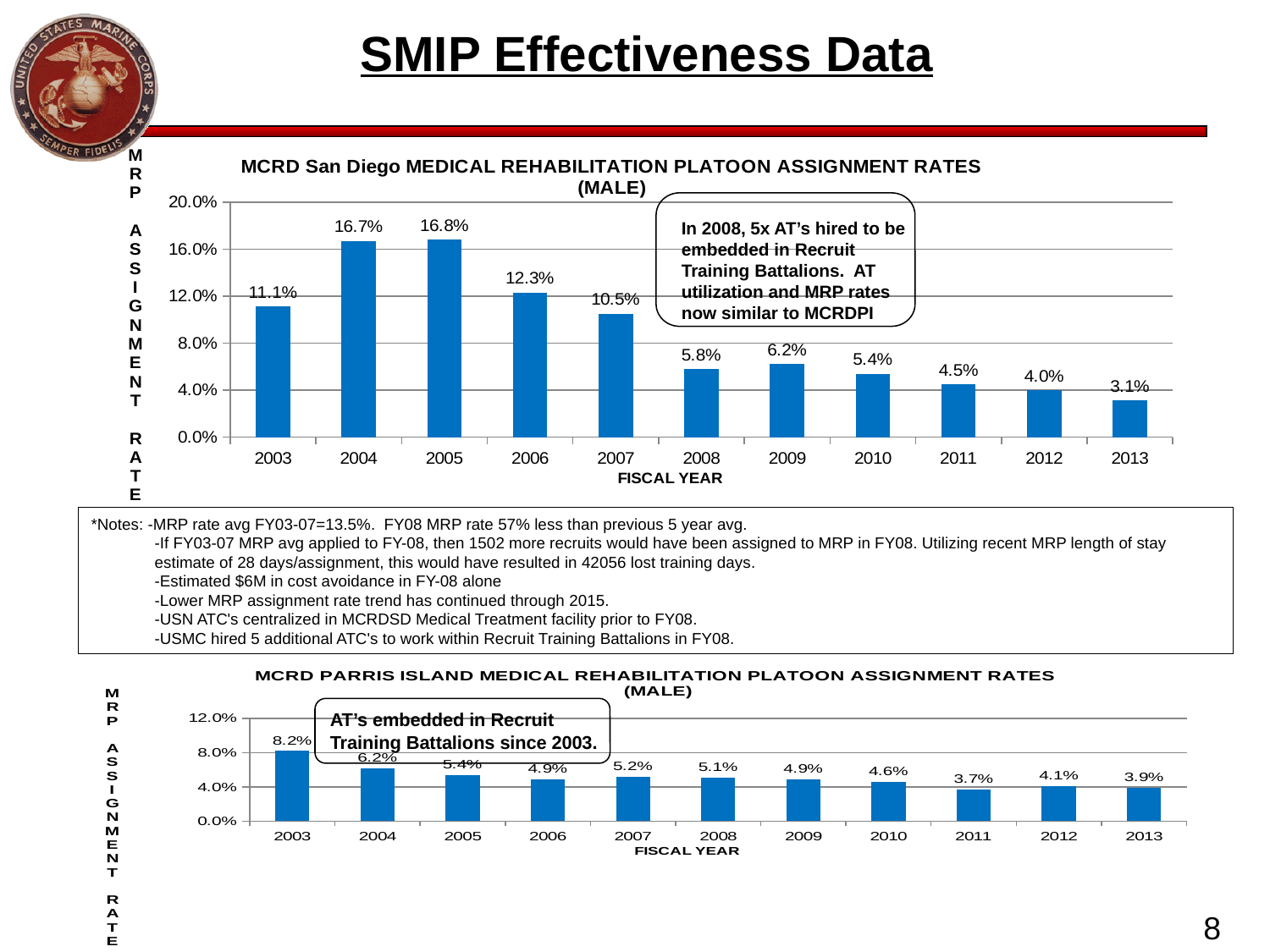
In the MCRD Parris Island chart, what is the MRP assignment rate for fiscal year 2011? 3.7% In the MCRD Parris Island chart, which fiscal year has the lowest MRP assignment rate? 2011 In the MCRD San Diego chart, which fiscal year has the lowest MRP assignment rate? 2013 In the MCRD Parris Island chart, which fiscal year has the highest MRP assignment rate? 2003 In the MCRD San Diego chart, how many fiscal years are plotted? 11 In the MCRD San Diego chart, do the MRP assignment rates generally rise or fall from 2005 to 2013? Fall In the MCRD San Diego chart, what is the difference between the 2007 and 2008 MRP assignment rates? 4.7% In the MCRD San Diego chart, which fiscal year has the highest MRP assignment rate? 2005 In the MCRD Parris Island chart, which is larger, the rate for 2004 or the rate for 2012? 2004 In the MCRD San Diego chart, what is the MRP assignment rate for fiscal year 2006? 12.3% In the MCRD Parris Island chart, what is the difference between the 2003 and 2013 MRP assignment rates? 4.3% What type of chart is the MCRD San Diego chart? Bar chart